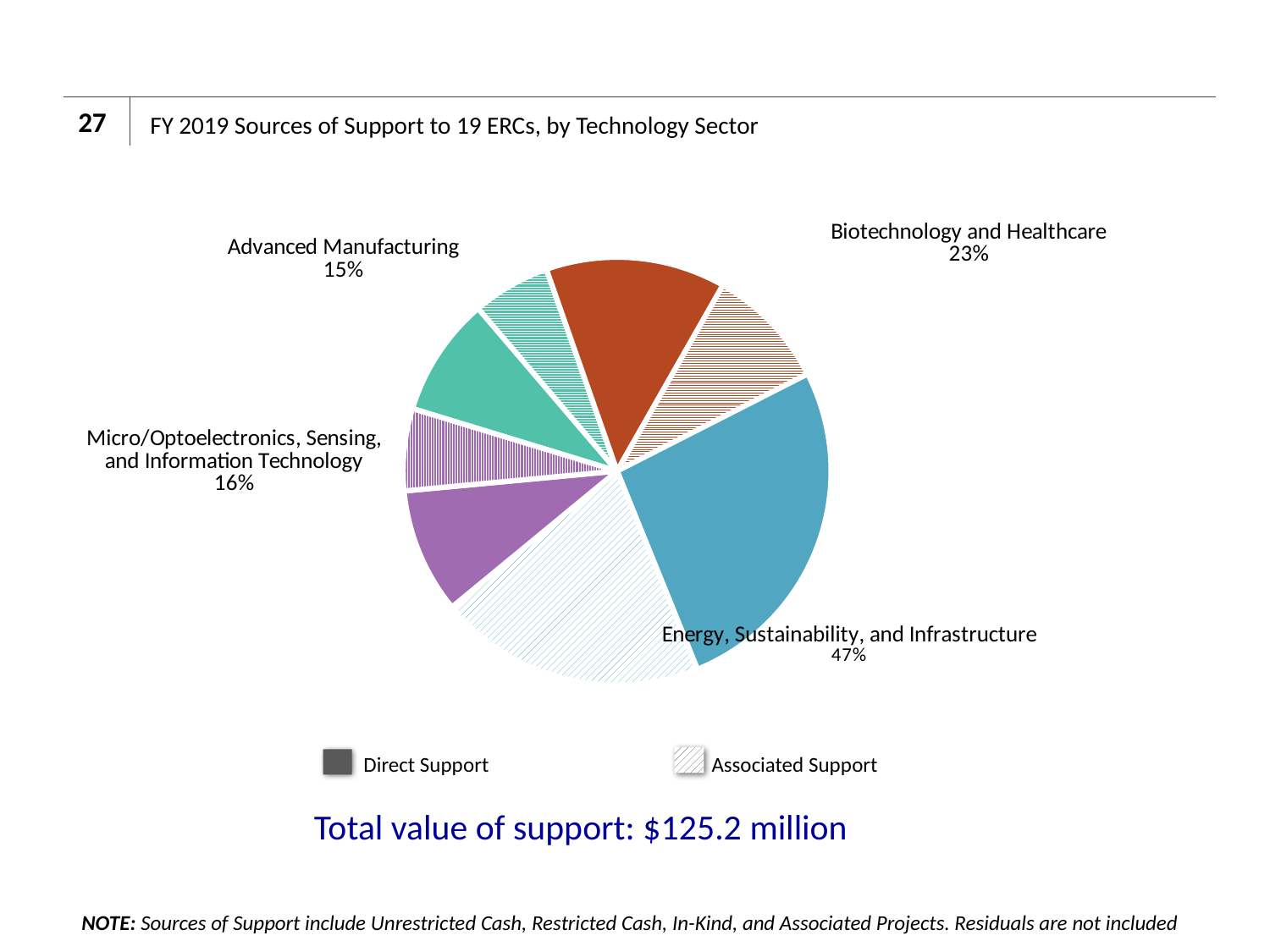
What share of support goes to Energy, Sustainability, and Infrastructure? 47% What type of chart is shown on the slide? pie chart What is the total value of support stated below the chart? $125.2 million How many entries does the legend list? 2 Which technology sector receives the smallest share of support? Advanced Manufacturing What share of support goes to Advanced Manufacturing? 15% How many technology sectors are labelled on the pie chart? 4 What share of support goes to Micro/Optoelectronics, Sensing, and Information Technology? 16% What share of support goes to Biotechnology and Healthcare? 23% Which technology sector receives the largest share of support? Energy, Sustainability, and Infrastructure Which has a larger share of support: Biotechnology and Healthcare or Micro/Optoelectronics, Sensing, and Information Technology? Biotechnology and Healthcare What is the difference in percentage points between the shares for Energy, Sustainability, and Infrastructure and Biotechnology and Healthcare? 24 percentage points